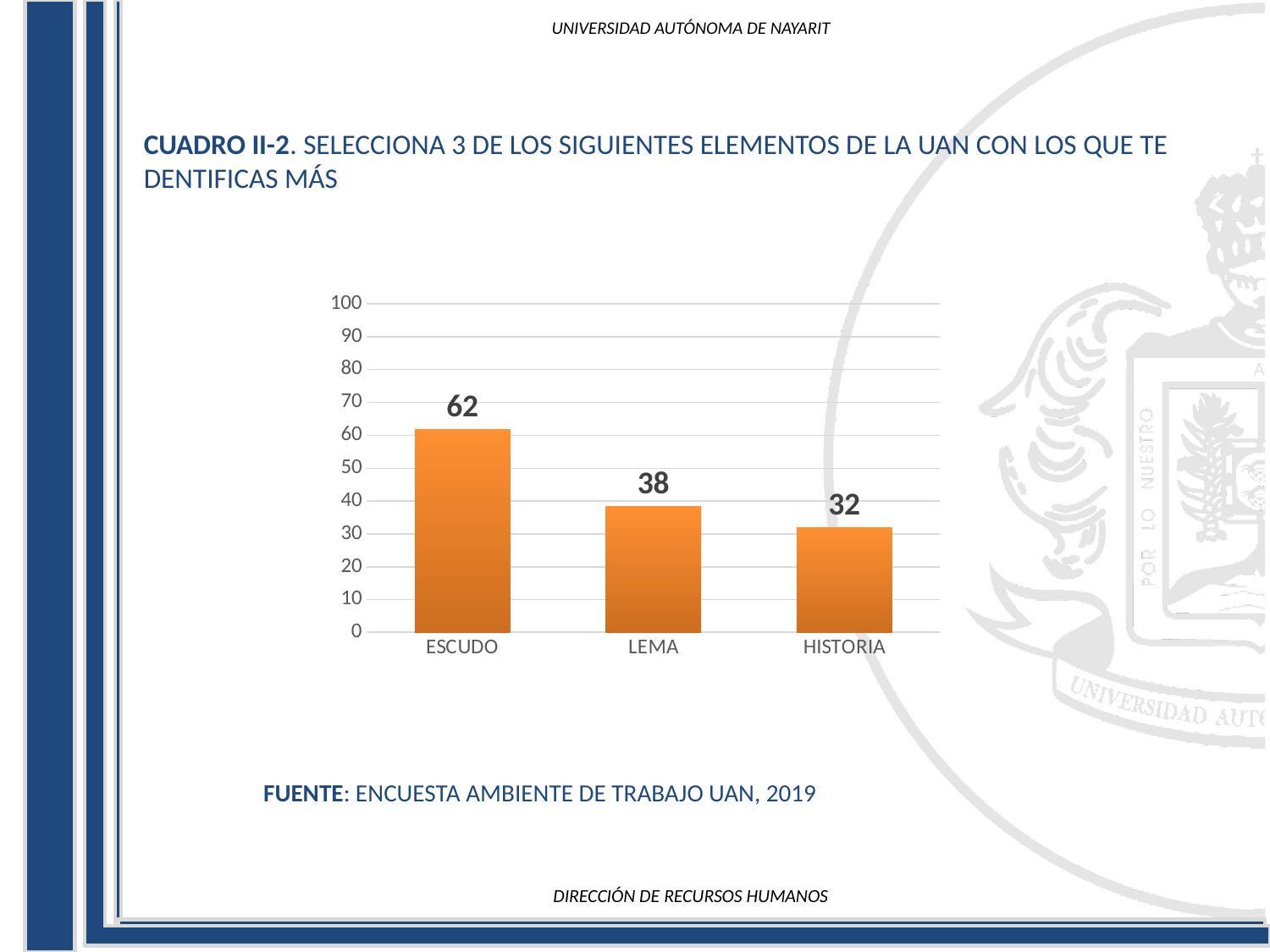
What is the difference between the values for LEMA and HISTORIA? 6 Is the value for ESCUDO greater or less than 50? greater Which category has the lowest value? HISTORIA Do the values rise or fall from left to right along the x axis? fall Which is larger, the value for ESCUDO or the value for HISTORIA? ESCUDO What kind of chart is shown on the slide? bar chart What is the value for ESCUDO? 62 How many categories are shown on the x axis? 3 What is the value for LEMA? 38 Which category has the highest value? ESCUDO What is the value for HISTORIA? 32 What is the difference between the values for ESCUDO and LEMA? 24